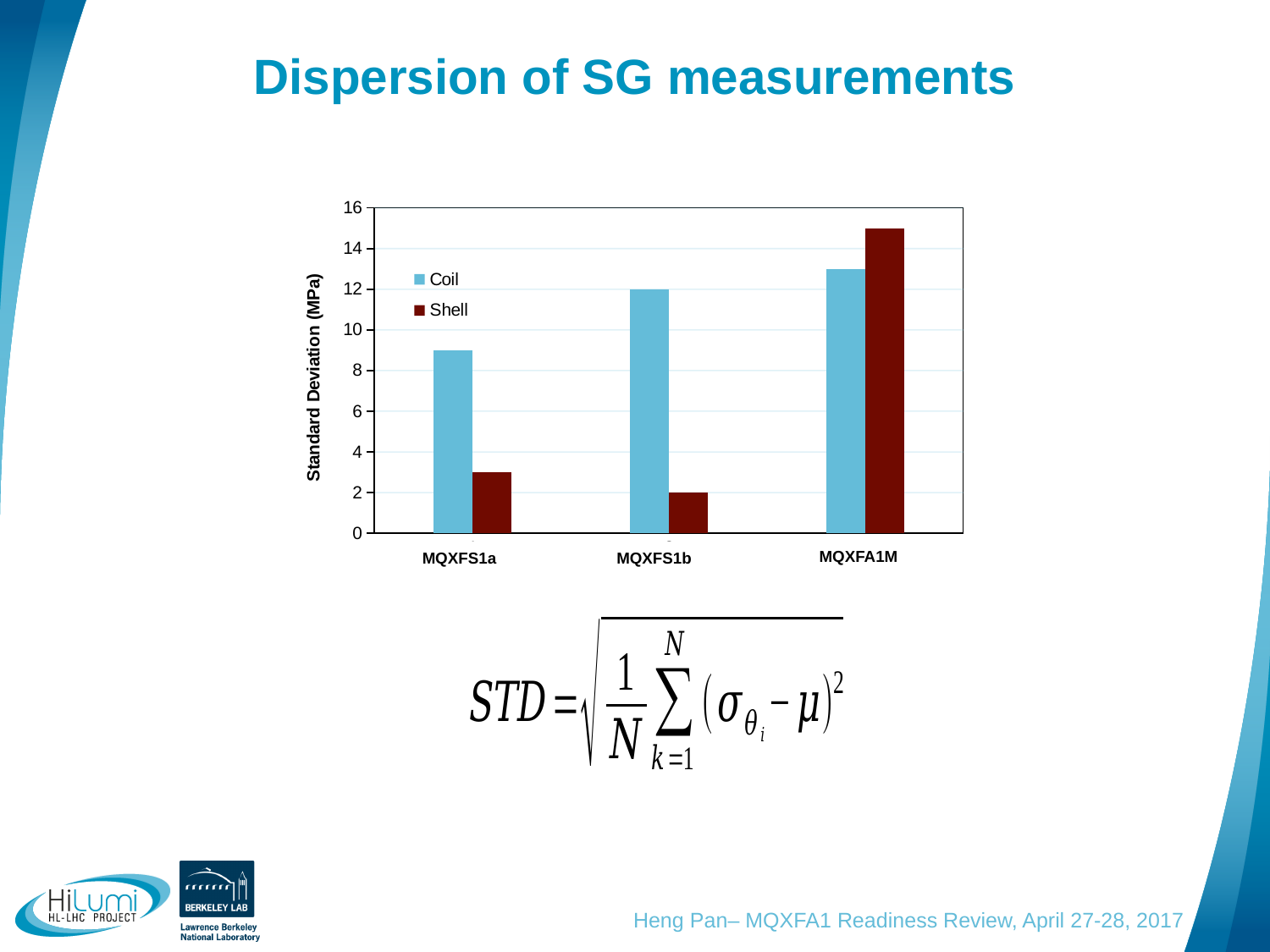
Which magnet has the highest Shell standard deviation? MQXFA1M How many series does the legend list? 2 What is the Shell standard deviation for MQXFS1b? 2 Is the Coil value for MQXFS1a greater or less than 8? greater What is the Coil standard deviation for MQXFS1b? 12 Which magnet has the lowest Shell standard deviation? MQXFS1b What is the label of the y axis? Standard Deviation (MPa) Which magnet has the lowest Coil standard deviation? MQXFS1a Is the Shell value for MQXFA1M greater or less than 14? greater How many magnet categories are shown on the x axis? 3 What kind of chart is shown on the slide? bar chart For MQXFA1M, which is larger, the Coil or the Shell standard deviation? Shell